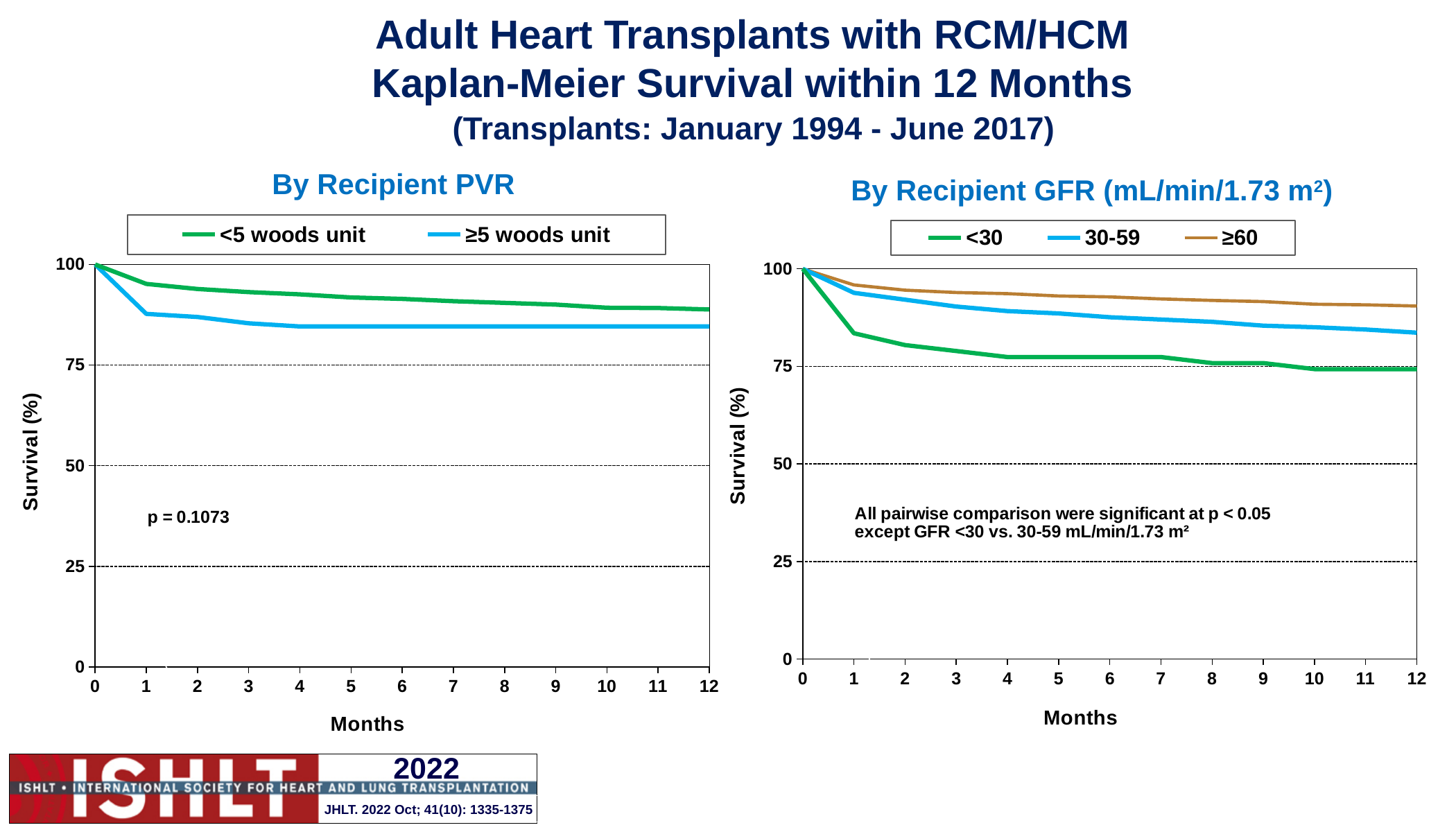
In the 'By Recipient GFR (mL/min/1.73 m²)' chart, which series has the lowest survival at 12 months? <30 In the 'By Recipient PVR' chart, what is the survival (%) for <5 woods unit at month 0? 100 In the 'By Recipient GFR (mL/min/1.73 m²)' chart, is the survival for 30-59 at 12 months greater or less than 75? greater In the 'By Recipient PVR' chart, do the survival curves rise or fall as months increase? fall How many series does the legend of the 'By Recipient PVR' chart list? 2 In the 'By Recipient GFR (mL/min/1.73 m²)' chart, which series has the highest survival at 12 months? ≥60 What p-value is printed on the 'By Recipient PVR' chart? p = 0.1073 What kind of chart is the 'By Recipient PVR' chart? line chart In the 'By Recipient GFR (mL/min/1.73 m²)' chart, what is the label of the y axis? Survival (%) How many series does the legend of the 'By Recipient GFR (mL/min/1.73 m²)' chart list? 3 In the 'By Recipient PVR' chart, which series has the higher survival at 12 months, <5 woods unit or ≥5 woods unit? <5 woods unit In the 'By Recipient PVR' chart, is the survival for ≥5 woods unit at 12 months greater or less than 75? greater